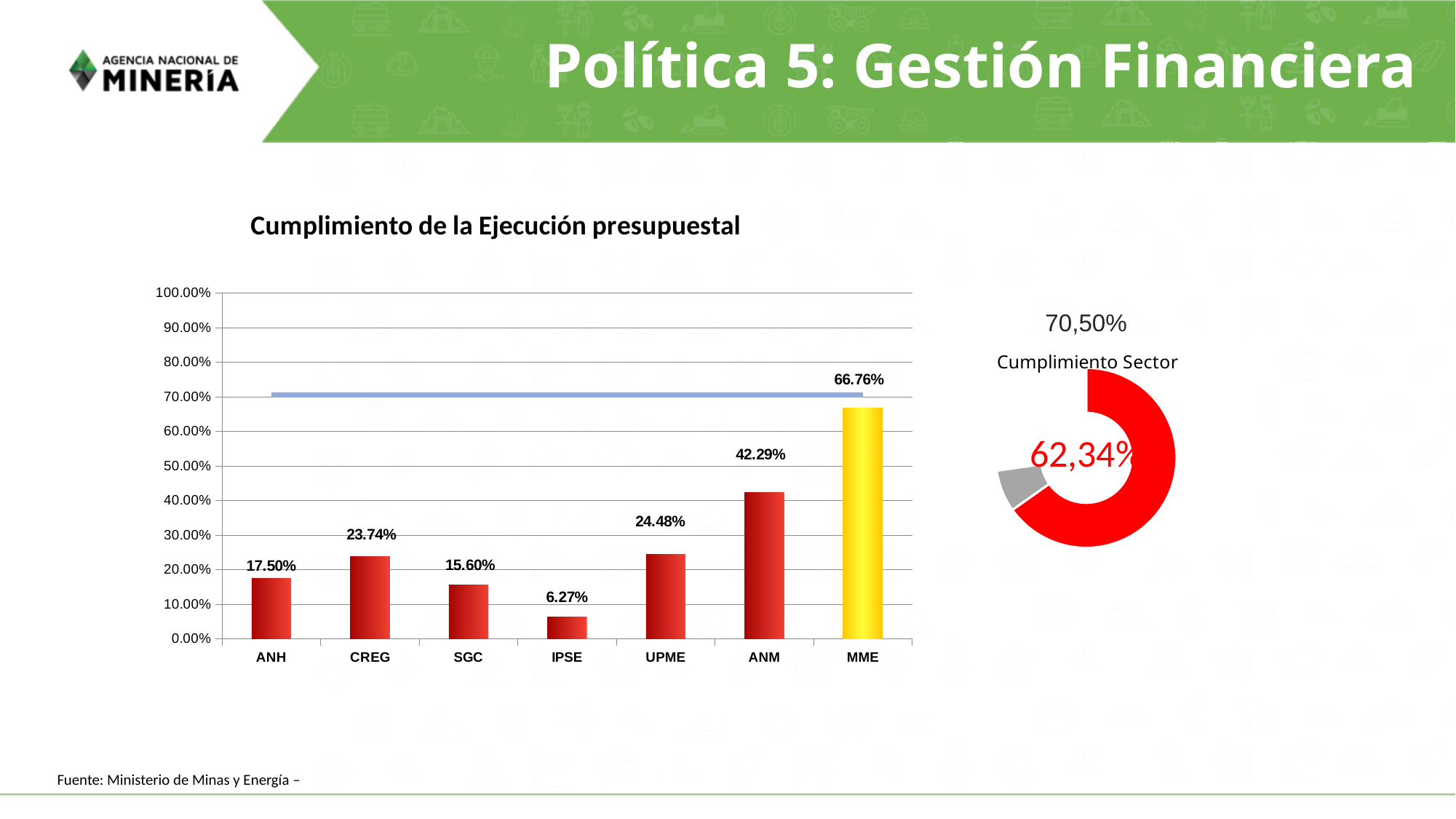
In the 'Cumplimiento de la Ejecución presupuestal' chart, what is the difference between the values for MME and ANM? 24.47% In the 'Cumplimiento Sector' chart on the right, what percentage is shown in the centre of the donut? 62,34% In the 'Cumplimiento de la Ejecución presupuestal' chart, which category has the lowest value? IPSE In the 'Cumplimiento de la Ejecución presupuestal' chart, which category has the highest value? MME What kind of chart is the 'Cumplimiento de la Ejecución presupuestal' chart? combination bar and line chart In the 'Cumplimiento de la Ejecución presupuestal' chart, what is the value for ANM? 42.29% How many categories are shown in the 'Cumplimiento de la Ejecución presupuestal' chart? 7 In the 'Cumplimiento de la Ejecución presupuestal' chart, which is larger, the value for ANH or the value for SGC? ANH In the 'Cumplimiento de la Ejecución presupuestal' chart, what is the value for MME? 66.76% In the 'Cumplimiento de la Ejecución presupuestal' chart, is the value for MME greater or less than 70%? less In the 'Cumplimiento de la Ejecución presupuestal' chart, what is the value for IPSE? 6.27% In the 'Cumplimiento de la Ejecución presupuestal' chart, which bar is coloured yellow instead of red? MME